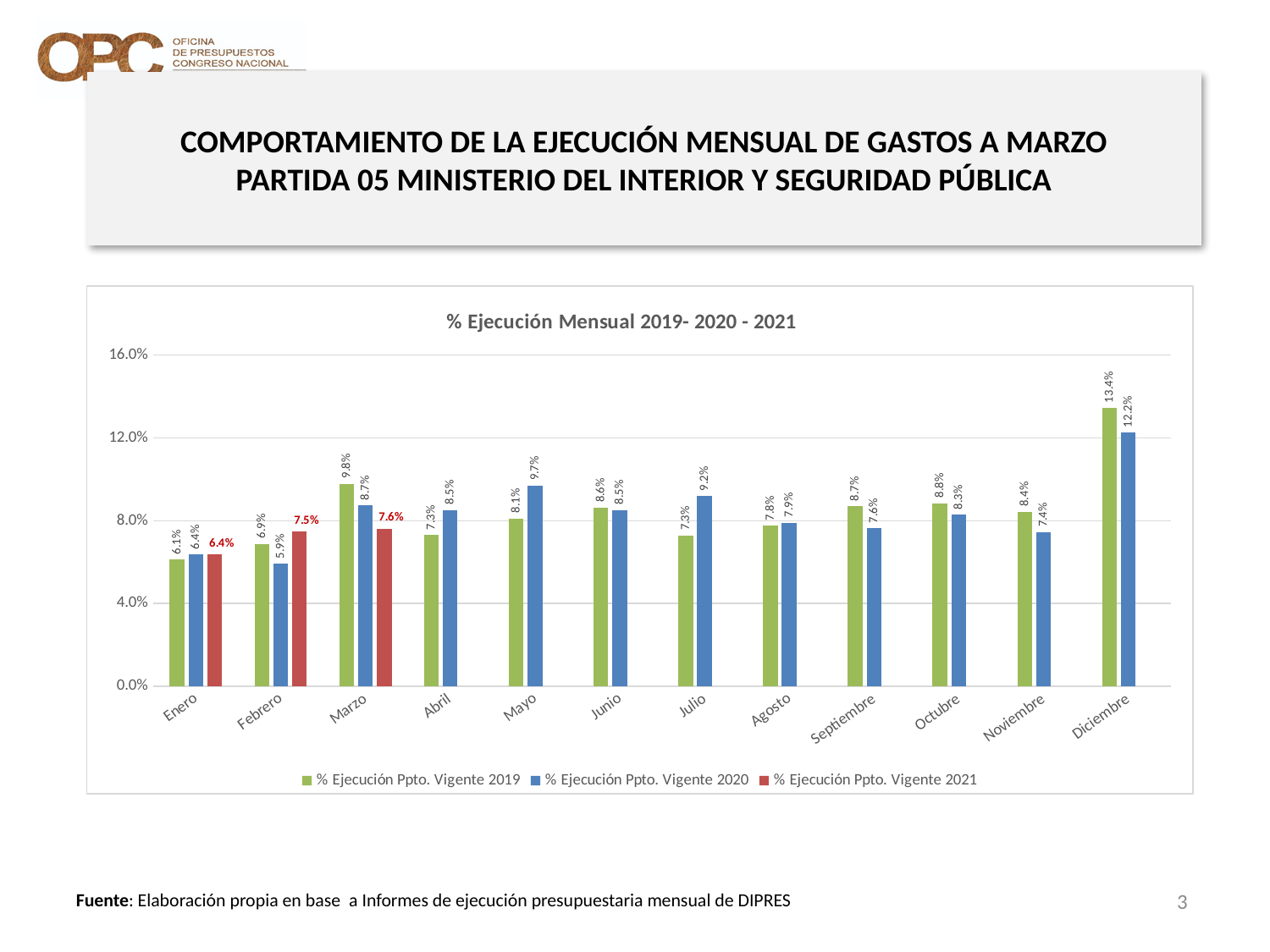
What is the title of the chart? % Ejecución Mensual 2019- 2020 - 2021 Which month has the lowest value for % Ejecución Ppto. Vigente 2020? Febrero Which month has the highest value for % Ejecución Ppto. Vigente 2019? Diciembre What is the value for % Ejecución Ppto. Vigente 2019 in Marzo? 9.8% In Marzo, which is larger: the 2019 value or the 2021 value? 2019 value What kind of chart is shown on the slide? bar chart How many months are shown on the x axis? 12 How many series does the legend list? 3 Is the value for % Ejecución Ppto. Vigente 2019 in Diciembre greater or less than 12.0%? greater What is the value for % Ejecución Ppto. Vigente 2020 in Diciembre? 12.2% What is the value for % Ejecución Ppto. Vigente 2021 in Febrero? 7.5% What is the difference between the 2019 and 2020 values in Mayo? 1.6%